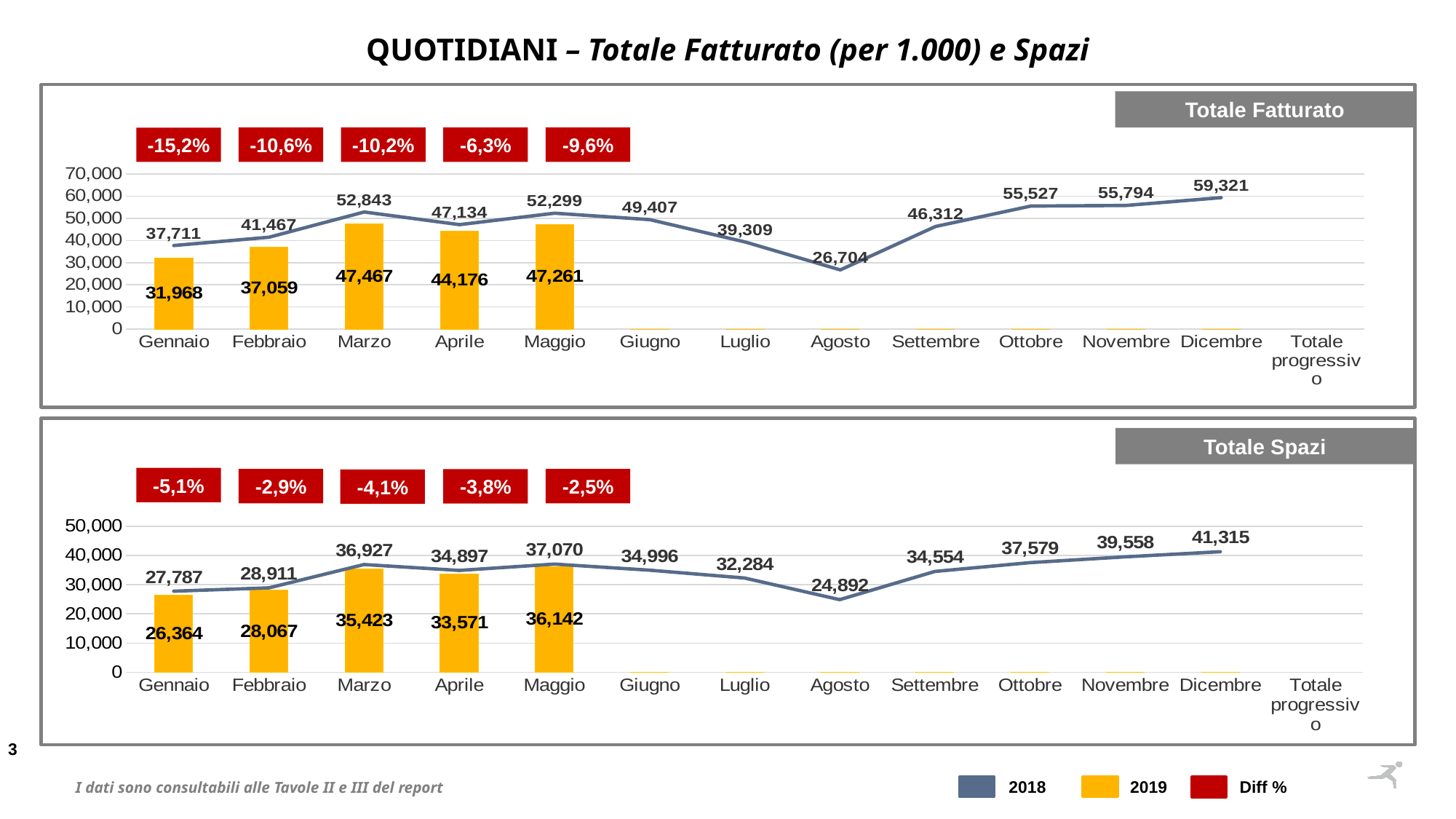
In the Totale Fatturato chart, what is the 2018 value for Marzo? 52,843 In the Totale Fatturato chart, what is the Diff % shown for Gennaio? -15,2% In the Totale Spazi chart, what is the 2018 value for Agosto? 24,892 In the Totale Fatturato chart, what is the difference between the 2018 and 2019 values for Marzo? 5,376 In the Totale Spazi chart, how many months have a 2019 bar plotted? 5 How many entries does the legend at the bottom of the slide list? 3 In the Totale Spazi chart, what is the 2019 value for Maggio? 36,142 In the Totale Fatturato chart, what is the 2019 value for Gennaio? 31,968 In the Totale Fatturato chart, which month has the lowest 2018 value? Agosto In the Totale Spazi chart, what is the difference between the 2018 and 2019 values for Maggio? 928 In the Totale Spazi chart, which is larger, the 2018 value for Ottobre or the 2018 value for Luglio? Ottobre In the Totale Fatturato chart, which month has the highest 2018 value? Dicembre